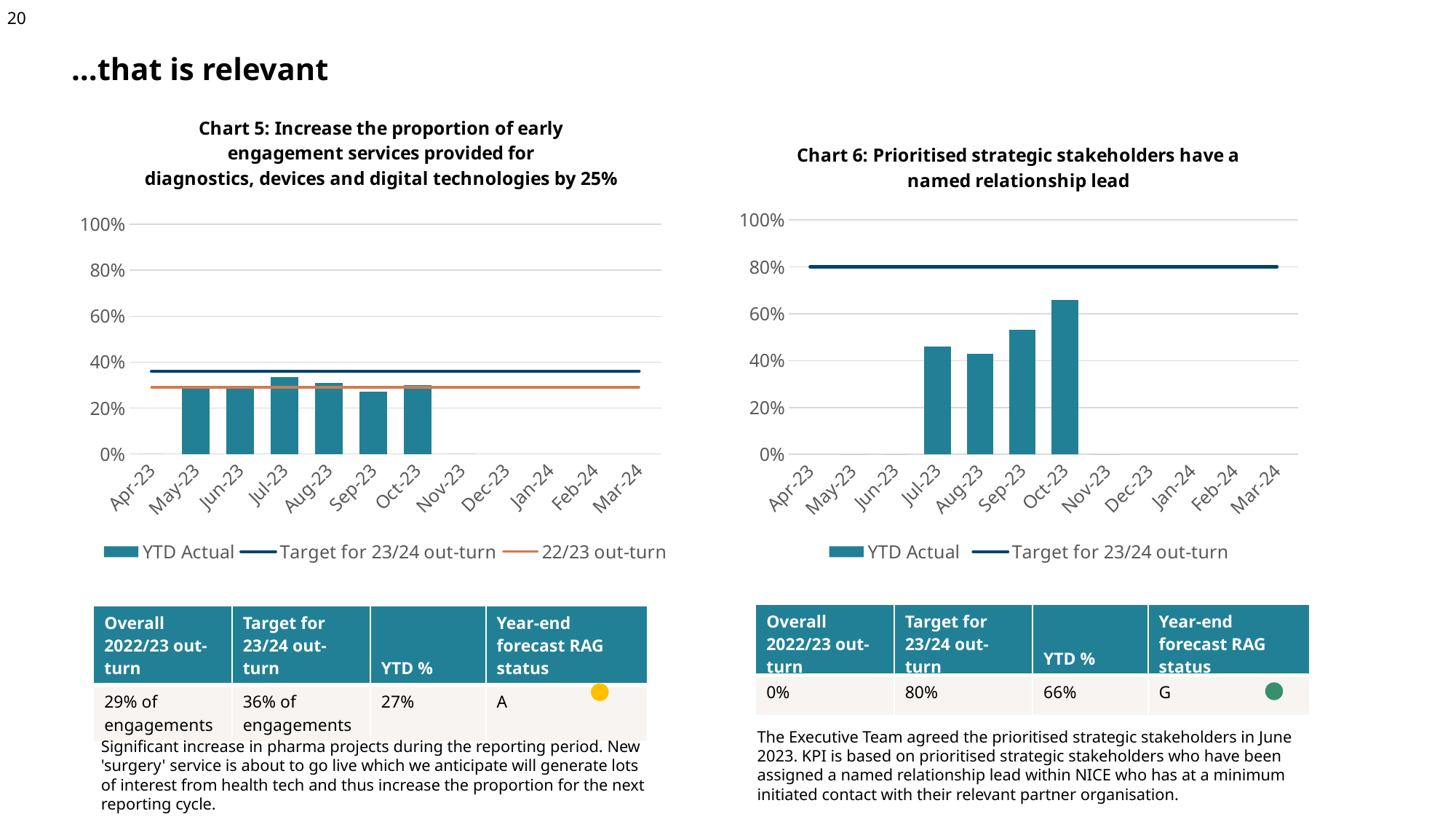
What kind of chart is Chart 6: Prioritised strategic stakeholders have a named relationship lead? Combination bar and line chart How many series does the legend of Chart 6 list? 2 How many months are shown on the x axis of Chart 5? 12 In Chart 6, at what level is the Target for 23/24 out-turn line drawn? 80% In Chart 5, how many months have a YTD Actual bar plotted? 6 In Chart 6, which is larger, the YTD Actual bar for Sep-23 or for Aug-23? Sep-23 In Chart 5, is the YTD Actual value for Sep-23 greater or less than 40%? less In Chart 6, is the YTD Actual value for Oct-23 greater or less than 60%? greater How many series does the legend of Chart 5 list? 3 In Chart 6, how many months have a YTD Actual bar plotted? 4 In Chart 6, is the YTD Actual value for Jul-23 greater or less than 60%? less In Chart 6, which month has the highest YTD Actual bar? Oct-23